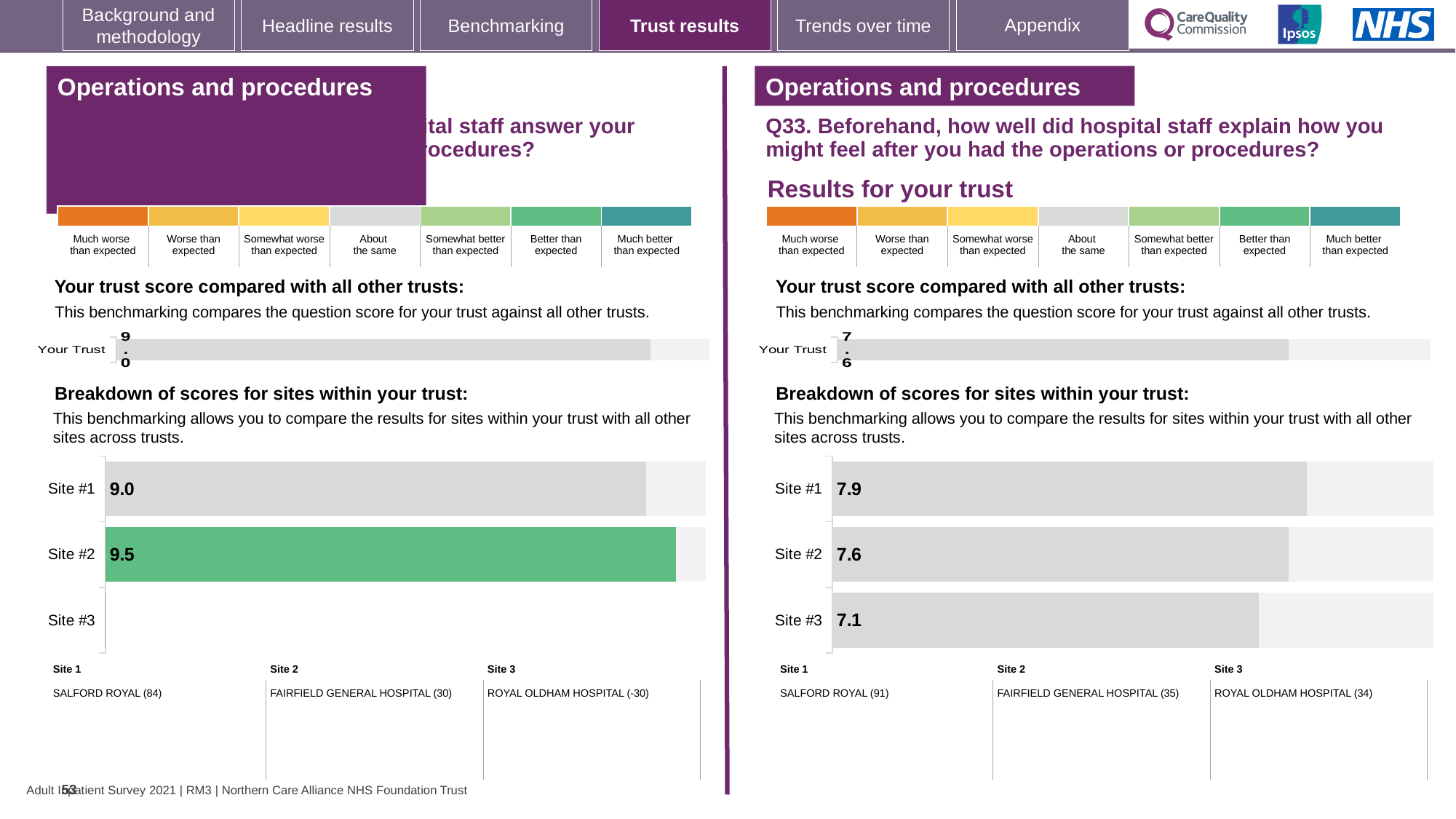
In the 'Breakdown of scores for sites within your trust' chart on the left half of the slide, what is the score for Site #1? 9.0 What kind of chart is the 'Breakdown of scores for sites within your trust' chart on the left half of the slide? Bar chart In the 'Breakdown of scores for sites within your trust' chart on the left half of the slide, what is the difference between the scores for Site #2 and Site #1? 0.5 In the 'Breakdown of scores for sites within your trust' chart on the right half of the slide (Q33), how many sites are listed? 3 In the 'Breakdown of scores for sites within your trust' chart on the right half of the slide (Q33), which site has the lowest score? Site #3 In the 'Breakdown of scores for sites within your trust' chart on the left half of the slide, which has the higher score, Site #1 or Site #2? Site #2 In the 'Breakdown of scores for sites within your trust' chart on the right half of the slide (Q33), what is the score for Site #3? 7.1 In the 'Breakdown of scores for sites within your trust' chart on the right half of the slide (Q33), what is the difference between the scores for Site #1 and Site #3? 0.8 In the 'Breakdown of scores for sites within your trust' chart on the right half of the slide (Q33), what is the score for Site #1? 7.9 In the 'Breakdown of scores for sites within your trust' chart on the left half of the slide, what is the score for Site #2? 9.5 In the 'Breakdown of scores for sites within your trust' chart on the right half of the slide (Q33), which site has the highest score? Site #1 In the 'Your trust score compared with all other trusts' chart on the right half of the slide (Q33), what is the score for Your Trust? 7.6